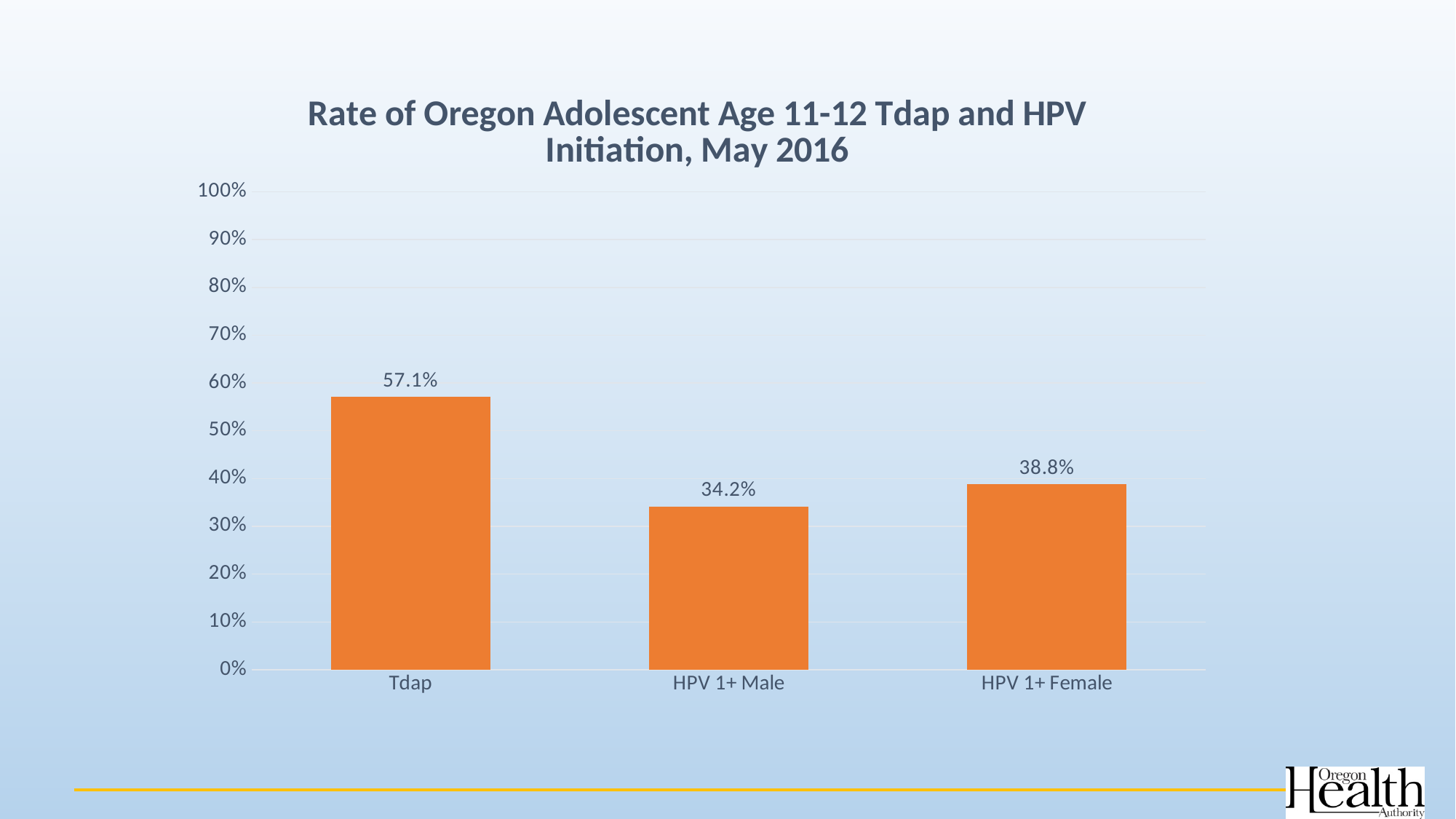
What is the difference between the HPV 1+ Female value and the HPV 1+ Male value? 4.6% Which is larger, the value for HPV 1+ Female or the value for HPV 1+ Male? HPV 1+ Female Is the value for Tdap greater or less than 50%? greater What kind of chart is shown on the slide? bar chart What is the value for HPV 1+ Male? 34.2% What is the value for HPV 1+ Female? 38.8% What is the value for Tdap? 57.1% What is the difference between the Tdap value and the HPV 1+ Male value? 22.9% What is the title of the chart? Rate of Oregon Adolescent Age 11-12 Tdap and HPV Initiation, May 2016 Which category has the highest value? Tdap Which category has the lowest value? HPV 1+ Male How many categories are shown on the x axis? 3